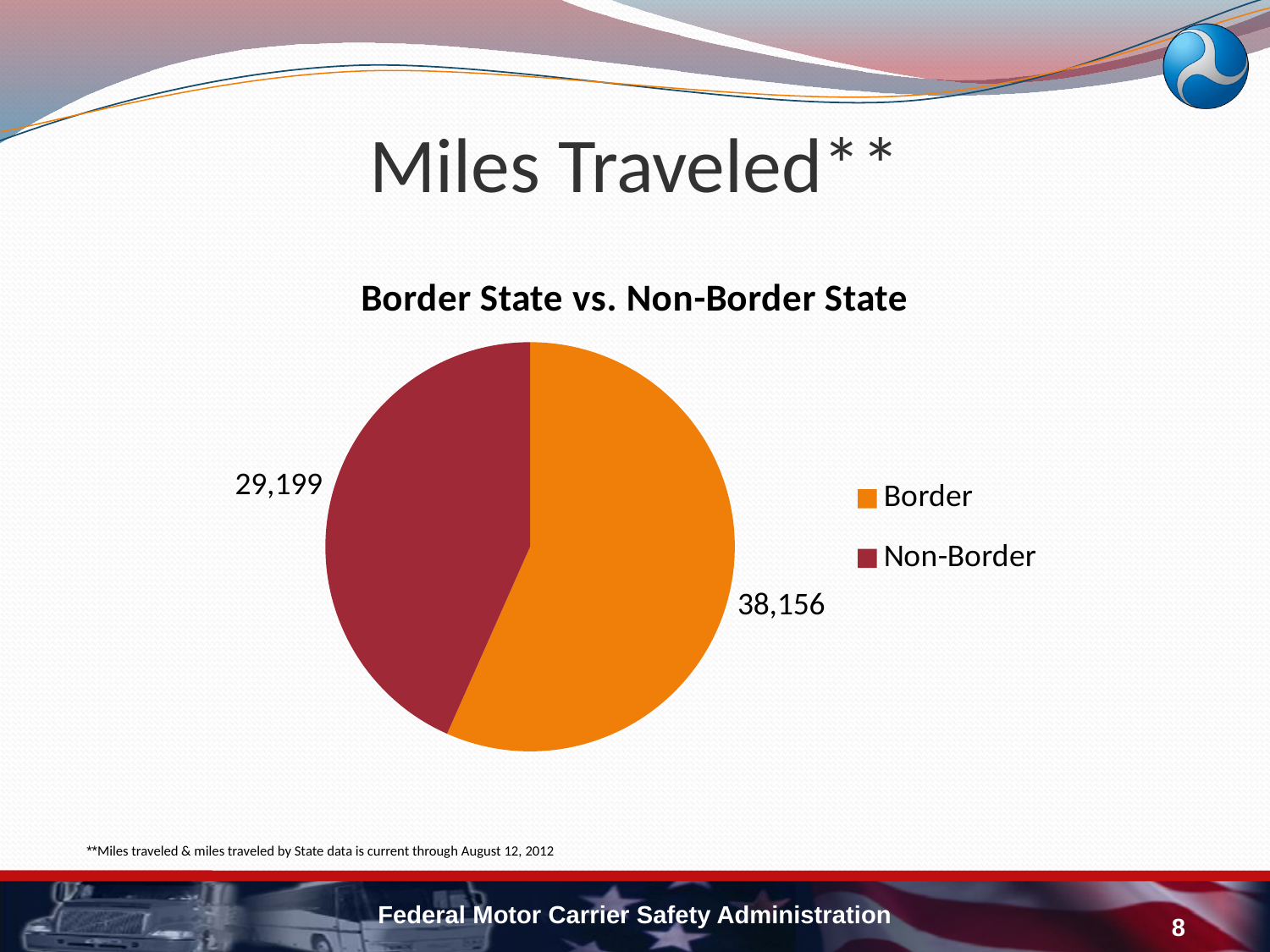
What is the value for Border? 38,156 Which category has the largest slice of the pie? Border How many categories does the pie chart show? 2 What colour is the Non-Border slice? Red What type of chart is shown on the slide? Pie chart What is the difference between the Border and Non-Border values? 8,957 What is the total of the two values shown in the pie chart? 67,355 What is the value for Non-Border? 29,199 Which category has the smallest slice of the pie? Non-Border How many entries does the legend list? 2 Which category has the larger value, Border or Non-Border? Border What is the title of the chart? Border State vs. Non-Border State